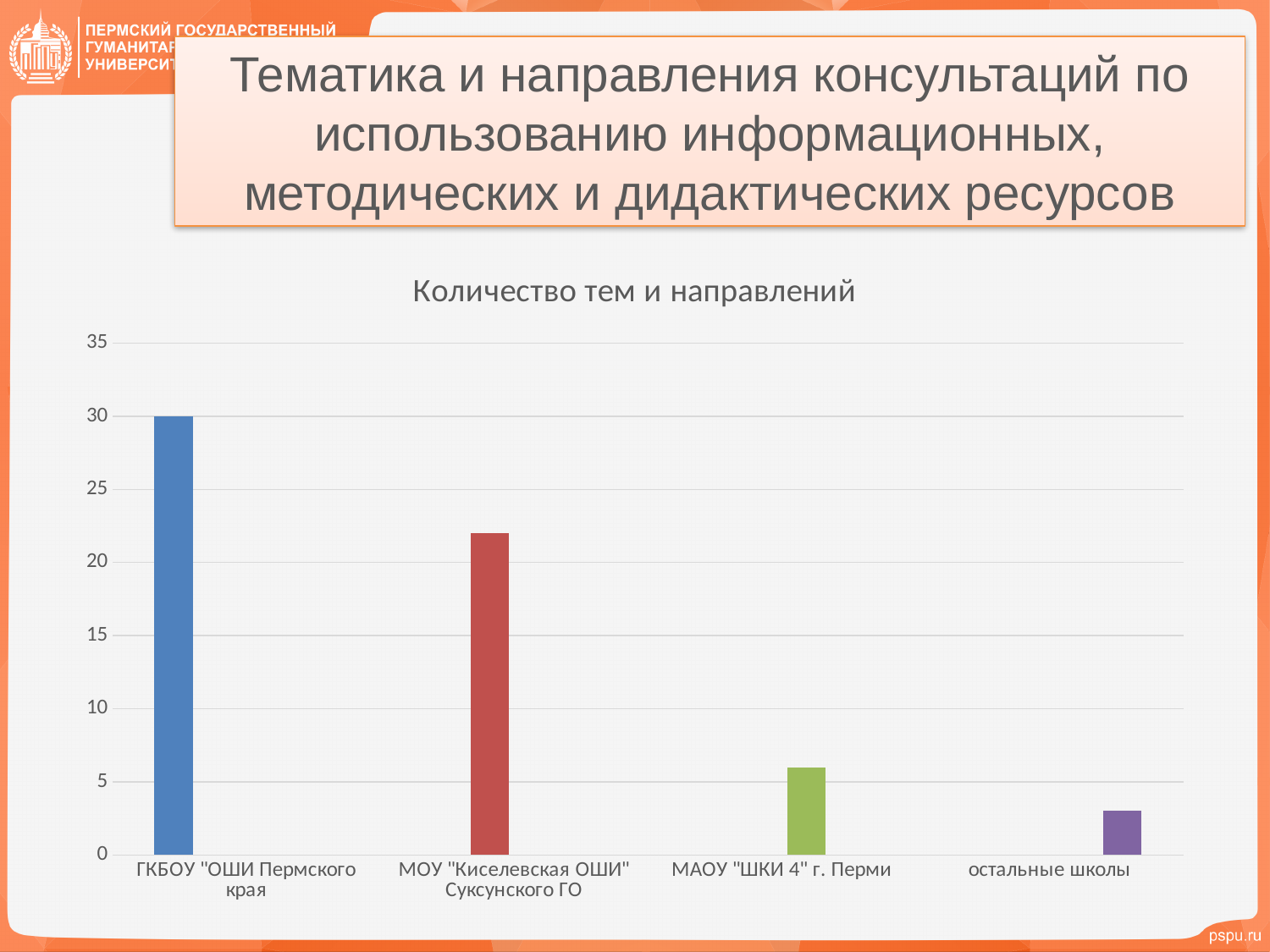
Which category has the highest value in the chart? ГКБОУ "ОШИ Пермского края" Is the value for МАОУ "ШКИ 4" г. Перми greater or less than 10? less Is the value for МОУ "Киселевская ОШИ" Суксунского ГО greater or less than 20? greater Do the values rise or fall from left to right along the x axis? Fall What is the title of the chart? Количество тем и направлений Is the value for остальные школы greater or less than 5? less Which is larger, the value for МОУ "Киселевская ОШИ" Суксунского ГО or the value for МАОУ "ШКИ 4" г. Перми? МОУ "Киселевская ОШИ" Суксунского ГО What kind of chart is shown on the slide? Bar chart How many categories are shown on the x axis of the chart? 4 Which category has the lowest value in the chart? остальные школы What is the value for ГКБОУ "ОШИ Пермского края"? 30